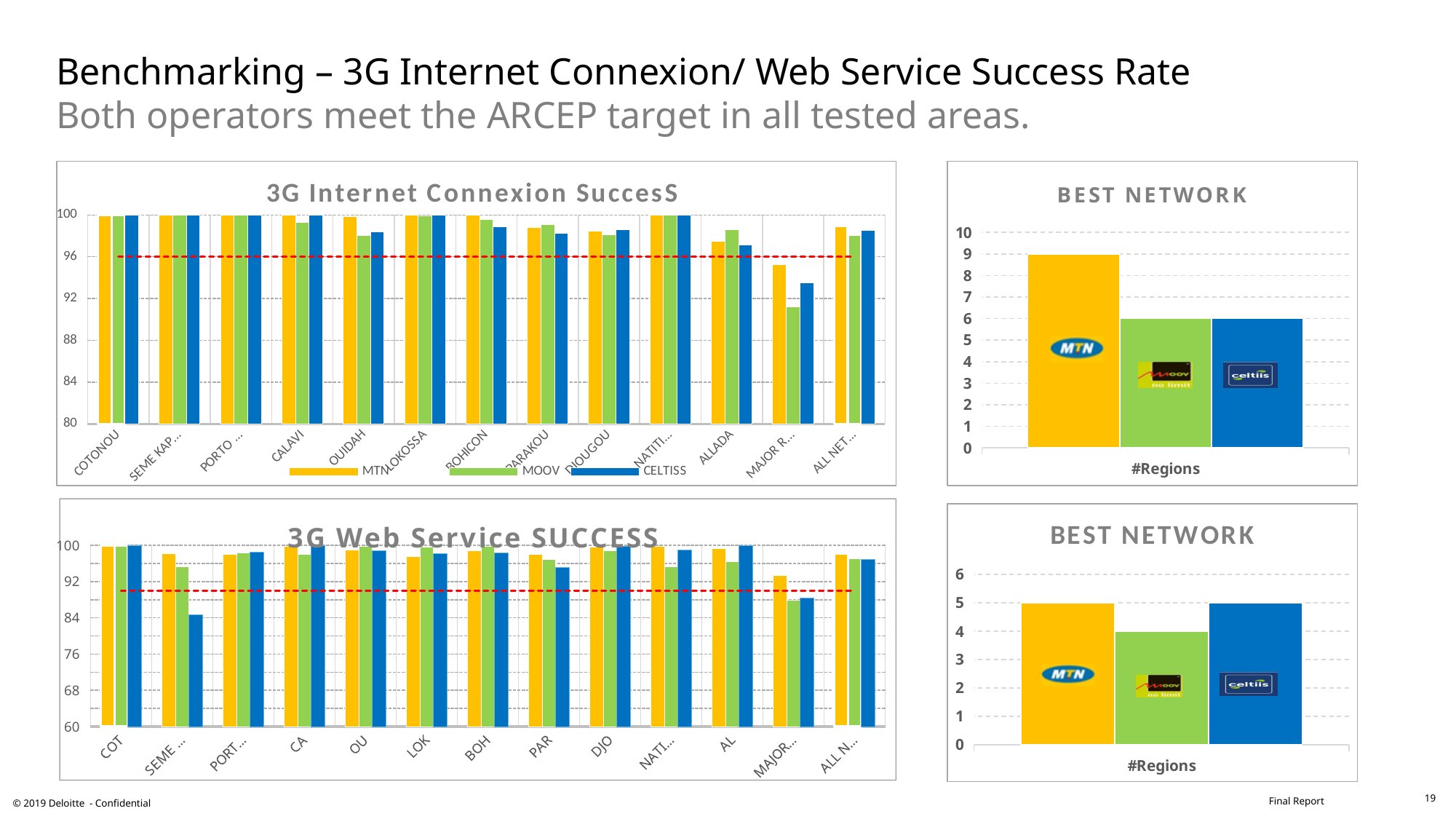
What kind of chart is the 3G Web Service SUCCESS chart? bar chart In the bottom-right BEST NETWORK chart, how many regions does CELTIIS win? 5 In the top-right BEST NETWORK chart, how many regions does MTN win? 9 In the top-right BEST NETWORK chart, how many regions does MOOV win? 6 In the 3G Web Service SUCCESS chart, is the CELTIIS value for SEME greater or less than 92? less How many categories are shown on the x axis of the 3G Internet Connexion SuccesS chart? 13 In the top-right BEST NETWORK chart, which operator has the highest number of regions? MTN In the bottom-right BEST NETWORK chart, which operator has the lowest number of regions? MOOV In the bottom-right BEST NETWORK chart, how many regions does MOOV win? 4 In the bottom-right BEST NETWORK chart, which is larger: the number of regions for MTN or for MOOV? MTN In the top-right BEST NETWORK chart, what is the difference between the number of regions for MTN and for CELTIIS? 3 How many series does the legend of the 3G Internet Connexion SuccesS chart list? 3